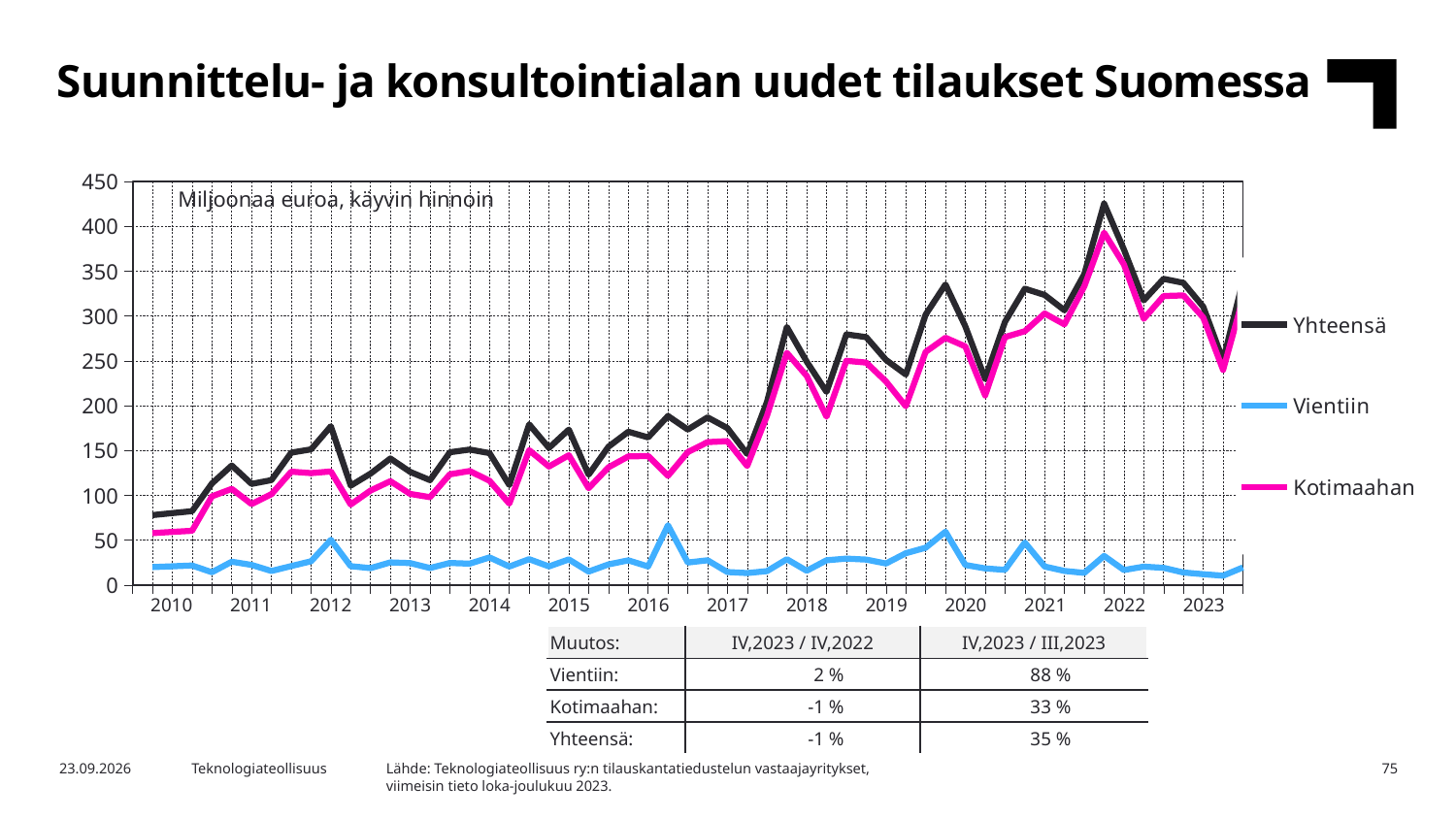
Which series has the lowest values throughout the chart? Vientiin How many series does the chart legend list? 3 Does the Yhteensä series overall rise or fall from 2010 to 2023? rise Is the peak value of Kotimaahan in late 2021 greater or less than 350? greater How many years are labelled on the x axis? 14 According to the table below the chart, what is the change for Vientiin in IV,2023 / III,2023? 88 % What unit is stated inside the chart area? Miljoonaa euroa, käyvin hinnoin Which series has the highest values throughout the chart? Yhteensä Is the peak value of Yhteensä in late 2021 greater or less than 400? greater Is the value of Yhteensä at the start of 2010 greater or less than 100? less What kind of chart is shown on the slide? Line chart Which series is shown with the blue line? Vientiin